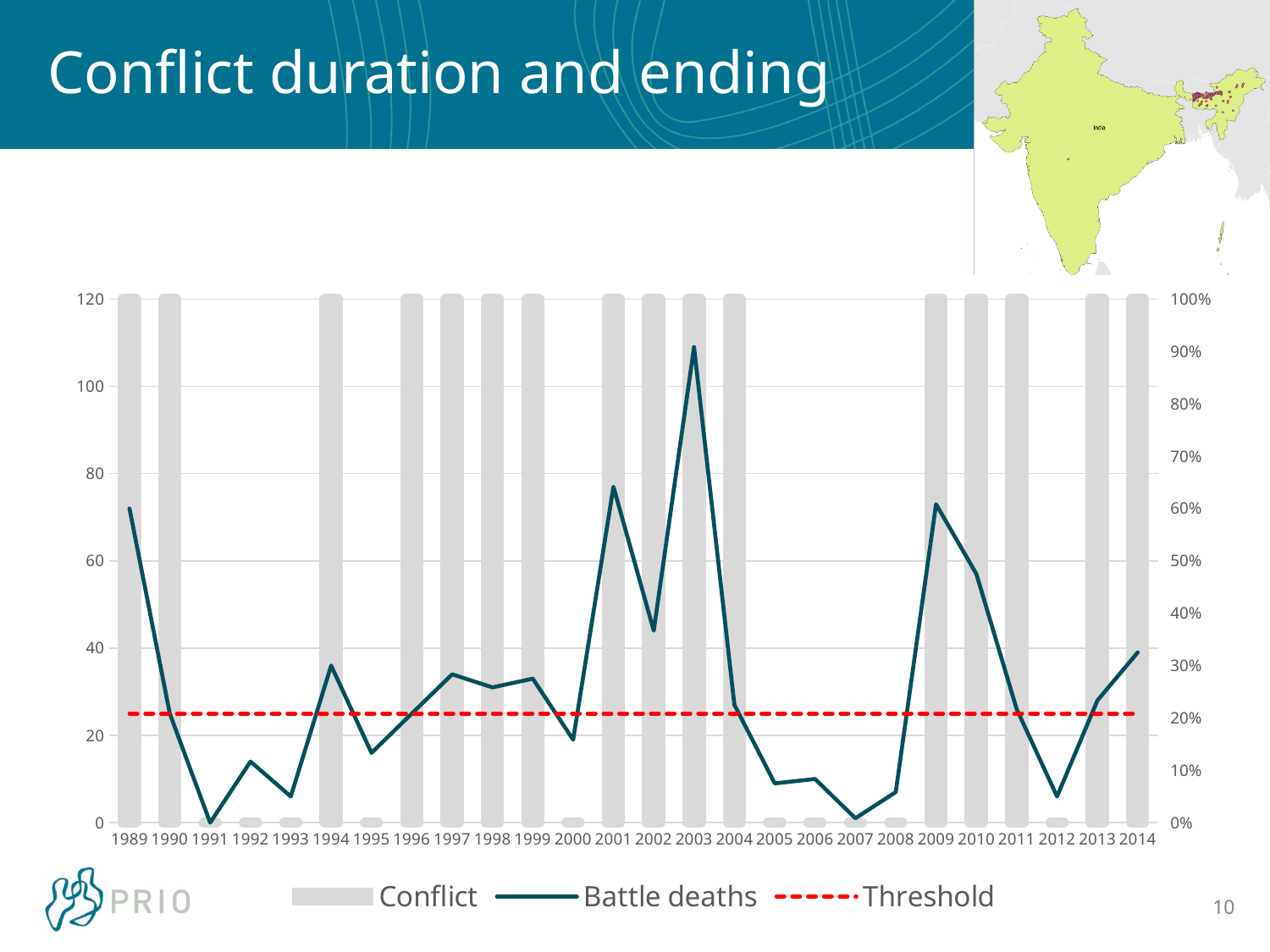
In which year is the Battle deaths line at its lowest? 1991 Is the Battle deaths value for 2012 greater or less than 20? less What are the three series named in the legend? Conflict, Battle deaths, Threshold Which year has the higher Battle deaths value, 1994 or 1995? 1994 Do the Battle deaths values rise or fall from 2009 to 2012? fall What is the Battle deaths value in 1991? 0 In which year is the Battle deaths line at its highest? 2003 How many years are shown along the x axis? 26 Is the Battle deaths value for 2001 greater or less than 60? greater Is the Battle deaths value for 2003 greater or less than 100? greater How many series does the chart legend list? 3 What kind of chart is shown on the slide? A combined bar and line chart